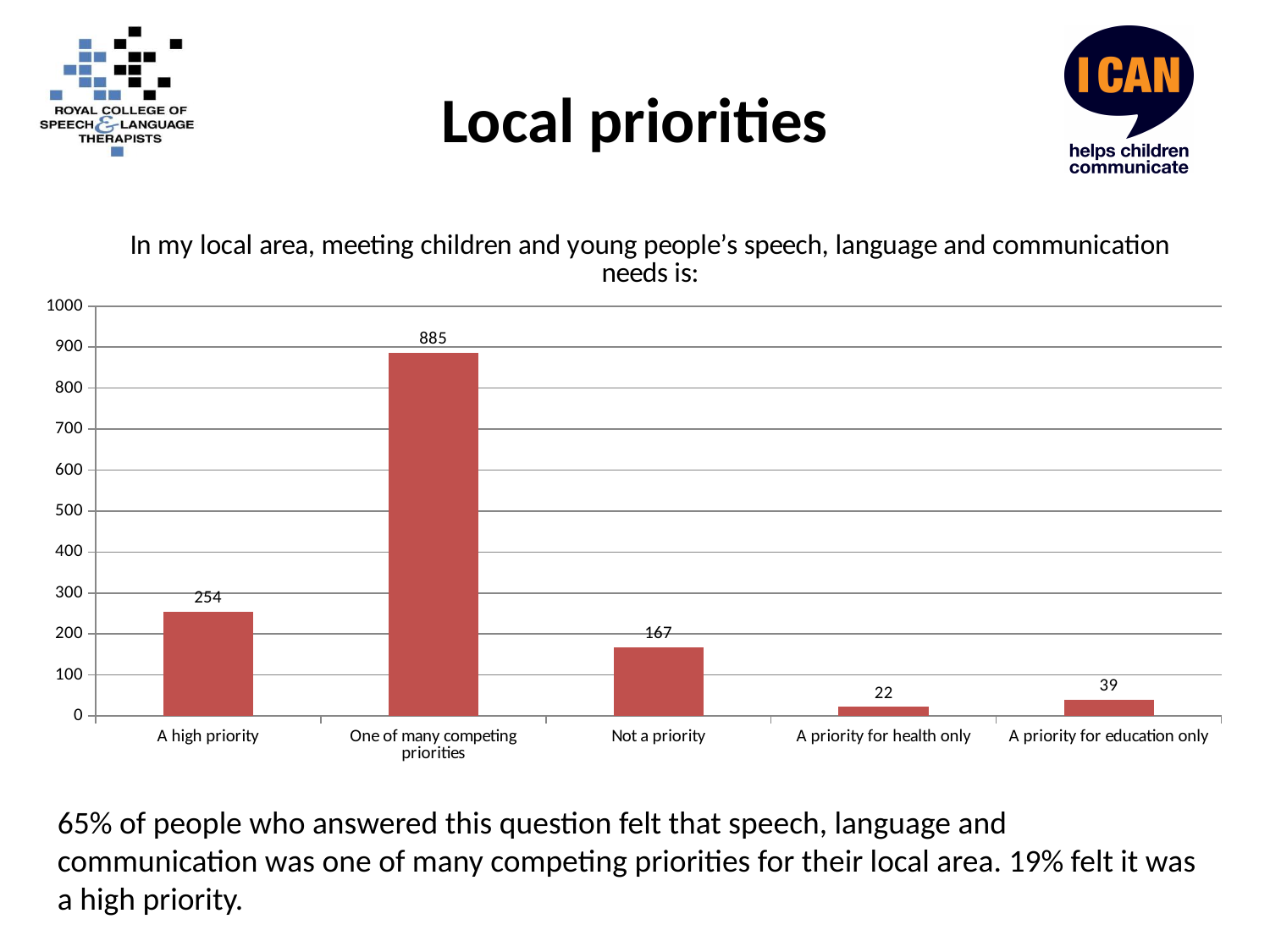
What is the difference between the values for 'A high priority' and 'Not a priority'? 87 What is the value for 'A priority for health only'? 22 What is the value for 'One of many competing priorities'? 885 Which category has the lowest value? A priority for health only What is the difference between the values for 'One of many competing priorities' and 'A high priority'? 631 How many categories are shown on the x axis? 5 What kind of chart is shown on the slide? Bar chart Which is larger: the value for 'A priority for education only' or 'A priority for health only'? A priority for education only What is the title of the chart? In my local area, meeting children and young people's speech, language and communication needs is: Which category has the highest value? One of many competing priorities Is the value for 'Not a priority' greater or less than 200? less What is the value for 'A high priority'? 254